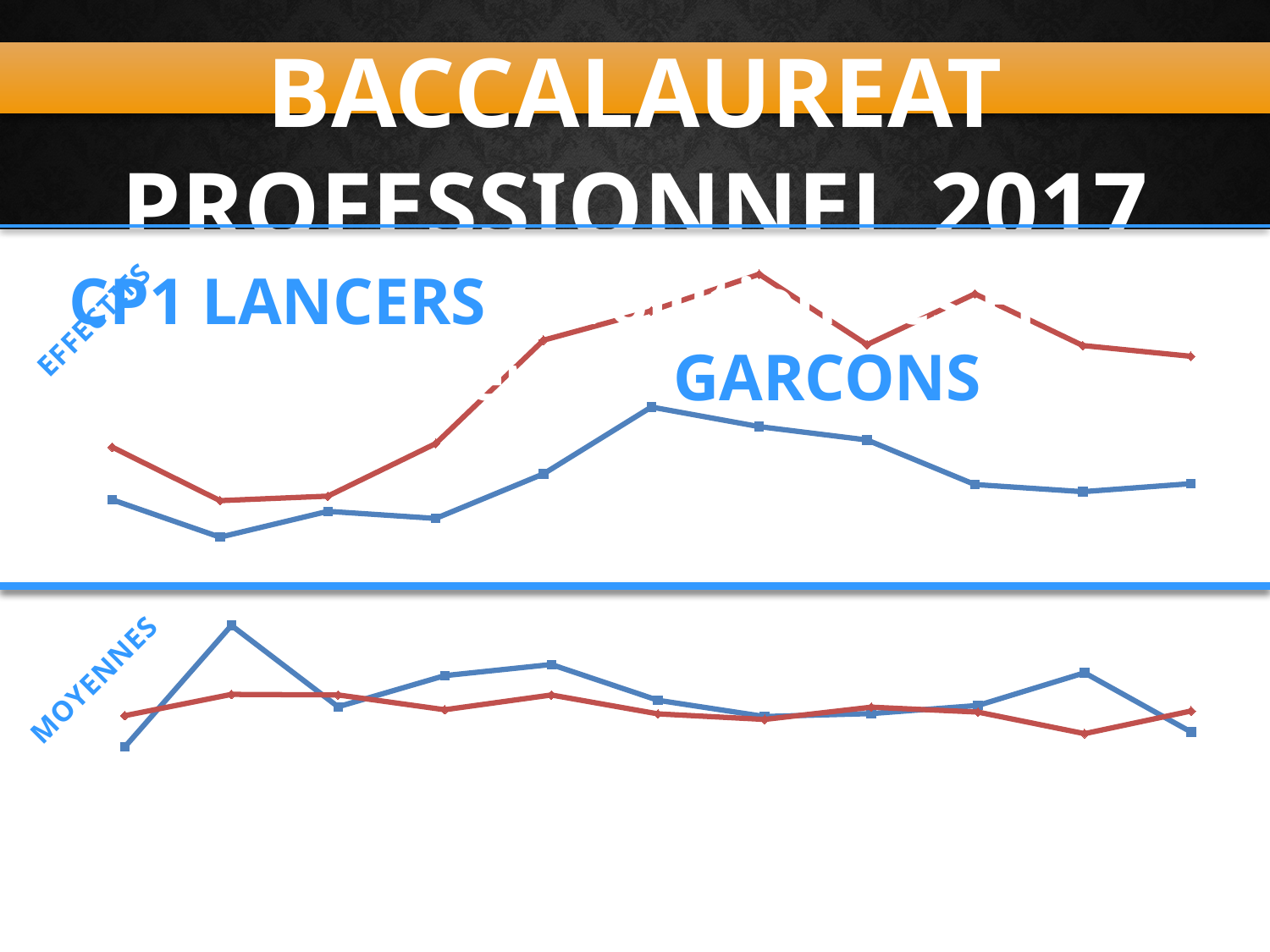
In the top chart (EFFECTIFS), does the red line end higher or lower than where it starts? higher In the bottom chart (MOYENNES), how many data points does each line have? 11 How many lines are plotted in the top chart (EFFECTIFS)? 2 What rotated label is shown at the left of the bottom chart? MOYENNES How many lines are plotted in the bottom chart (MOYENNES)? 2 In the top chart (EFFECTIFS), which line is higher at the rightmost point, the red line or the blue line? red What kind of chart is the top chart (EFFECTIFS)? line chart What kind of chart is the bottom chart (MOYENNES)? line chart In the top chart (EFFECTIFS), how many data points does each line have? 11 What rotated label is shown at the left of the top chart? EFFECTIFS